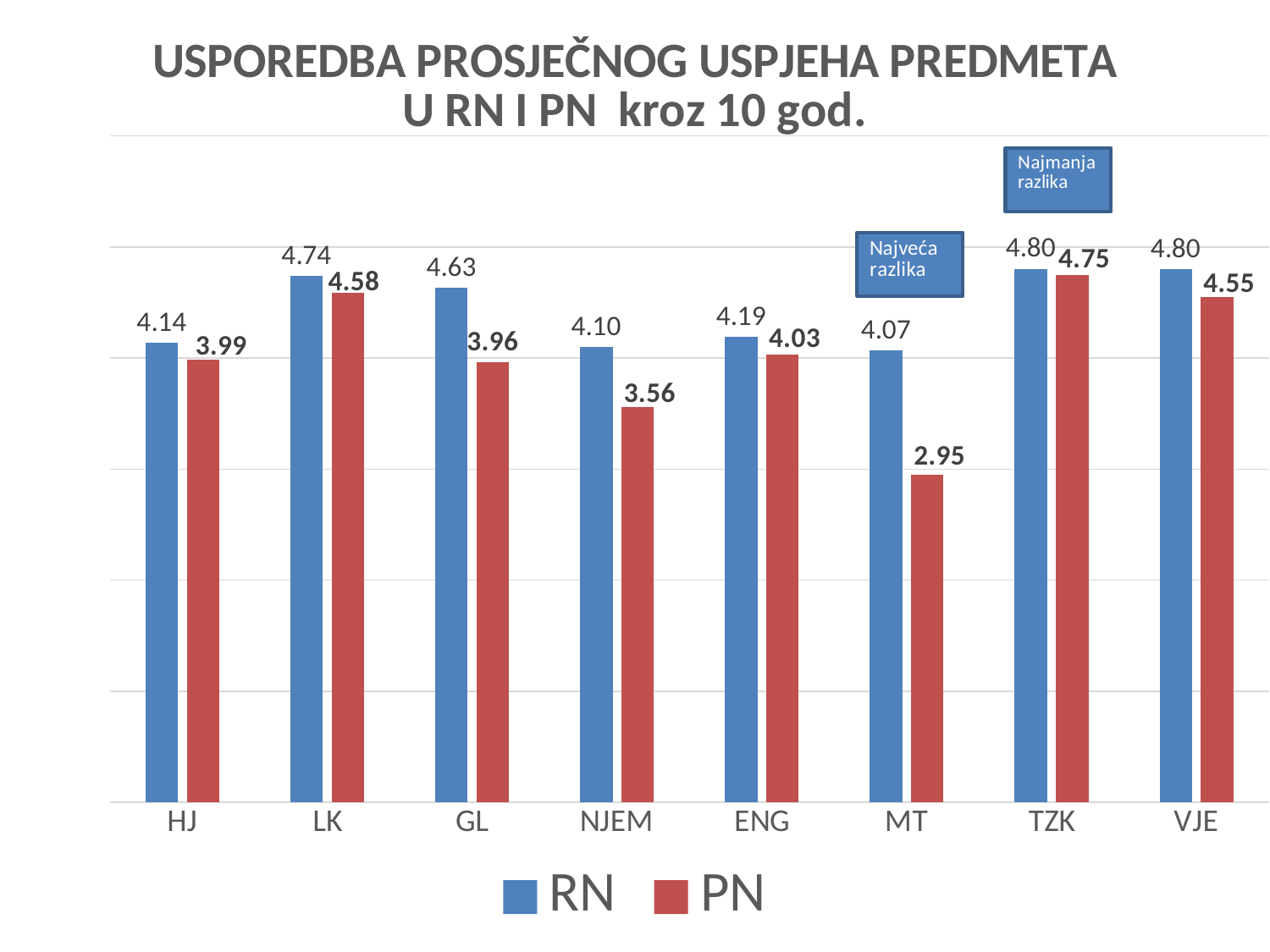
What is the difference between the RN and PN values for TZK? 0.05 What is the RN value for LK? 4.74 What is the PN value for NJEM? 3.56 What is the RN value for ENG? 4.19 How many categories are shown on the x axis? 8 What is the PN value for MT? 2.95 What kind of chart is shown on the slide? Bar chart Which category has the lowest PN value? MT What is the difference between the RN and PN values for MT? 1.12 How many series does the legend list? 2 Which is larger, the PN value for LK or the PN value for VJE? PN value for LK Which category has the highest PN value? TZK